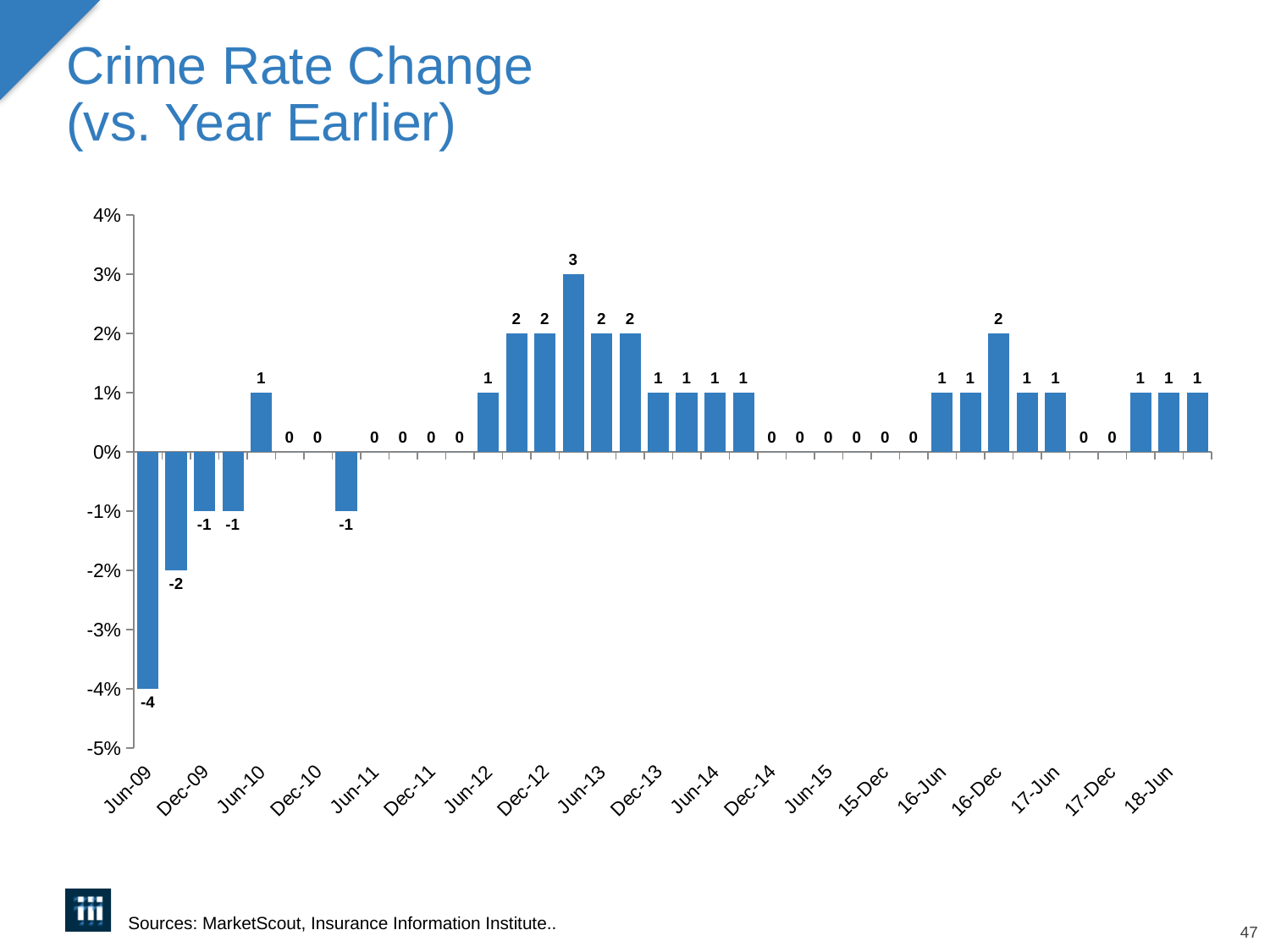
Which period has the lowest crime rate change? Jun-09 Is the value for Jun-09 greater or less than -3%? less What type of chart is shown on the slide? bar chart Which is larger, the value for Jun-09 or the value for Jun-10? Jun-10 What is the crime rate change value for 16-Dec? 2 What is the title of the chart on the slide? Crime Rate Change (vs. Year Earlier) What is the crime rate change value for Jun-10? 1 What is the maximum value shown on the vertical axis? 4% What is the difference between the values for 16-Dec and 18-Jun? 1 What is the crime rate change value for Jun-09? -4 What is the crime rate change value for 18-Jun? 1 What is the highest value shown in the chart? 3